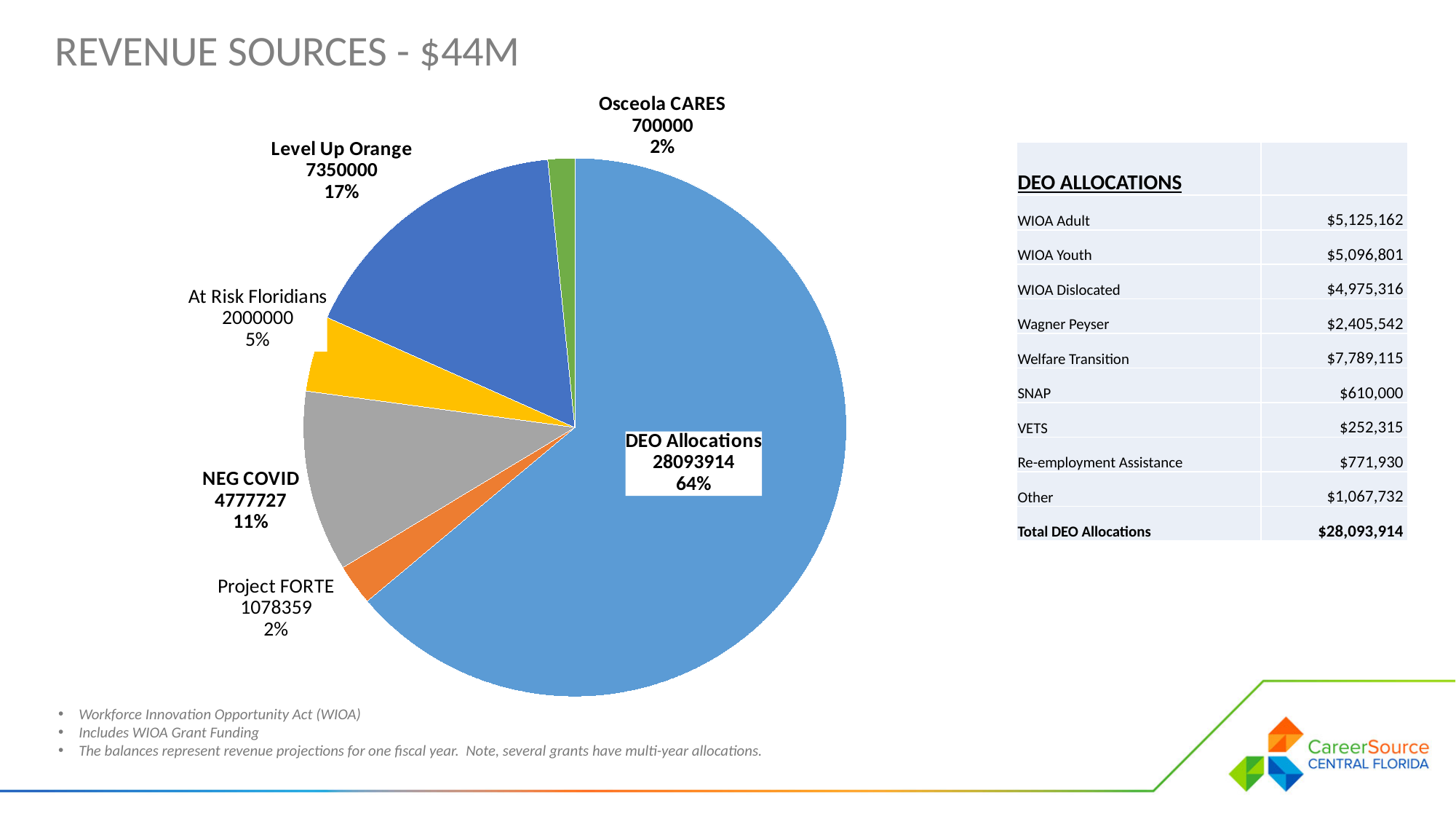
What is the value for Project FORTE in the pie chart? 1078359 What share of the pie does Level Up Orange represent? 17% What is the value for DEO Allocations in the pie chart? 28093914 How many slices does the pie chart have? 6 Which category has the largest slice in the pie chart? DEO Allocations What share of the pie does NEG COVID represent? 11% What is the difference between the values for Level Up Orange and NEG COVID? 2572273 What is the value for Level Up Orange in the pie chart? 7350000 What kind of chart is shown on the slide? pie chart Which category has the smallest slice in the pie chart? Osceola CARES Which is larger, the value for At Risk Floridians or the value for Project FORTE? At Risk Floridians What is the value for NEG COVID in the pie chart? 4777727